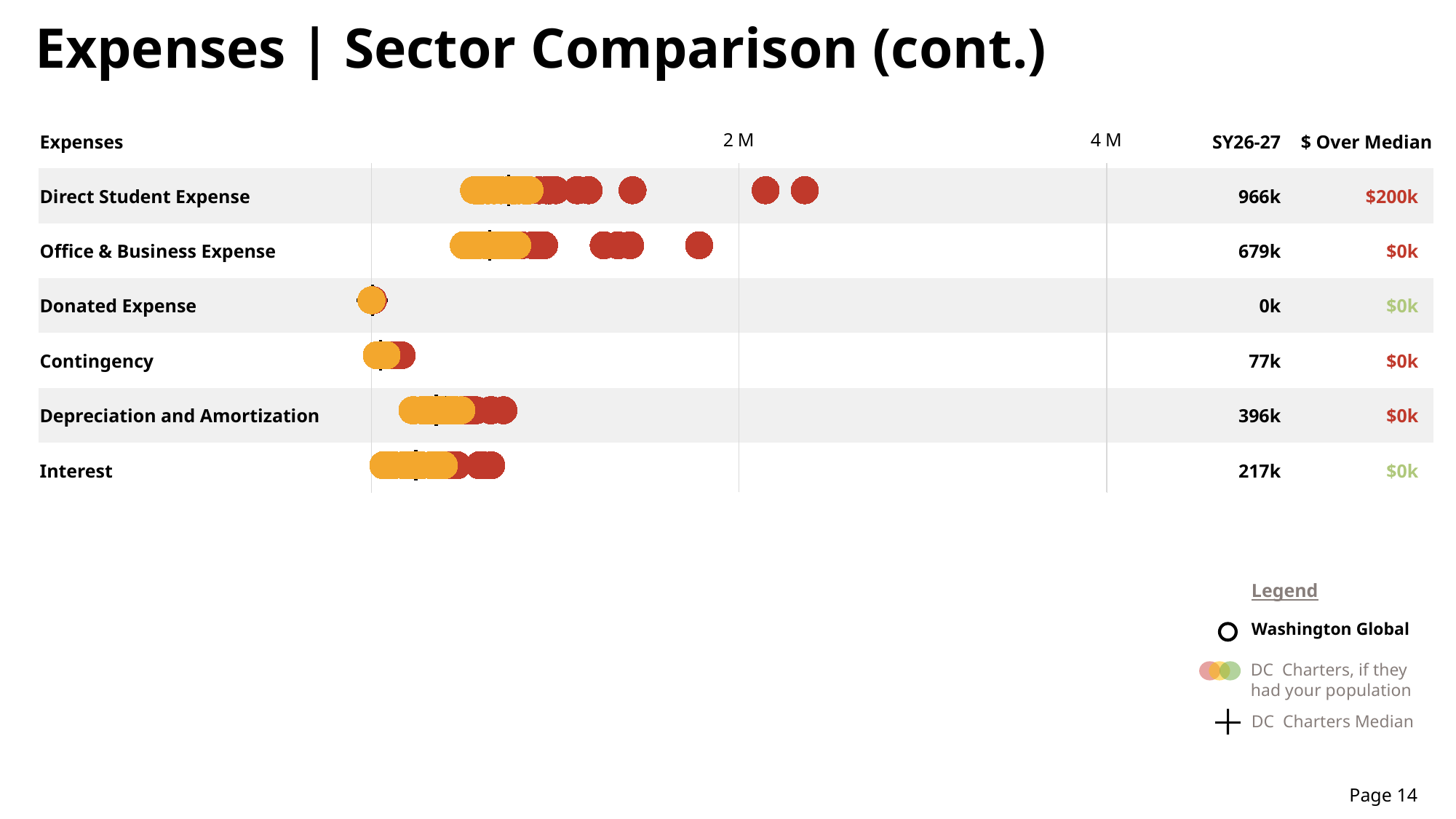
What is the SY26-27 value for Office & Business Expense? 679k What is the $ Over Median value for Direct Student Expense? $200k What kind of chart is shown on the slide? Dot plot Which expense category has the lowest SY26-27 value? Donated Expense How many entries does the legend list? 3 Which has a larger SY26-27 value, Interest or Contingency? Interest Which expense category has the highest SY26-27 value? Direct Student Expense What is the SY26-27 value for Direct Student Expense? 966k How many expense categories are shown in the chart? 6 What are the two axis tick labels shown above the chart? 2 M and 4 M What is the SY26-27 value for Depreciation and Amortization? 396k What is the difference between the SY26-27 values for Direct Student Expense and Office & Business Expense? 287k